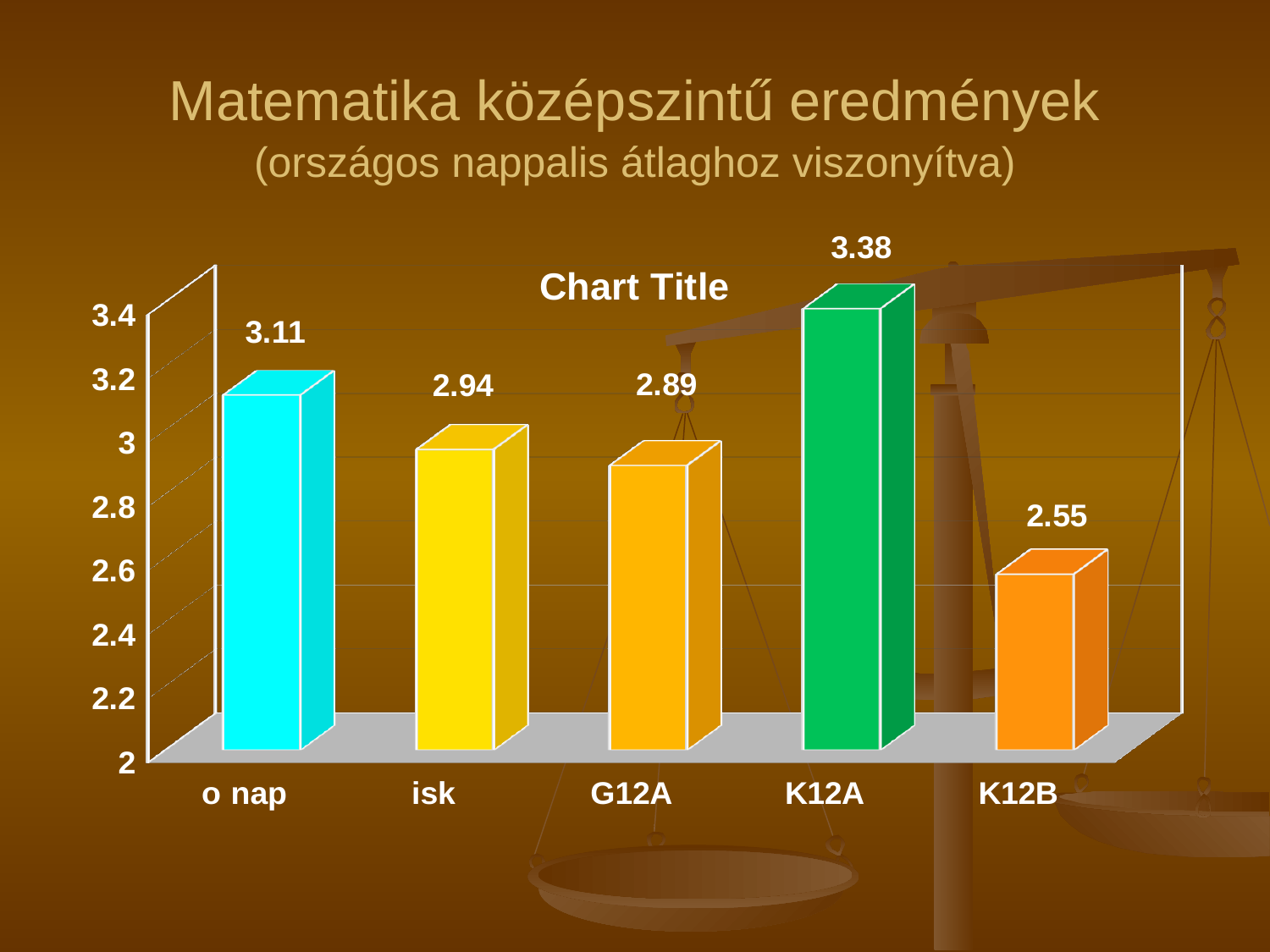
How many categories are shown on the x axis? 5 What is the title printed inside the chart area? Chart Title Is the value for K12B greater or less than 2.8? less What is the value for o nap? 3.11 What is the difference between the values for o nap and isk? 0.17 What kind of chart is shown on the slide? bar chart Which category has the lowest value? K12B What is the difference between the values for K12A and K12B? 0.83 Which category has the highest value? K12A What is the value for G12A? 2.89 What is the value for K12A? 3.38 Which is larger, the value for isk or the value for G12A? isk